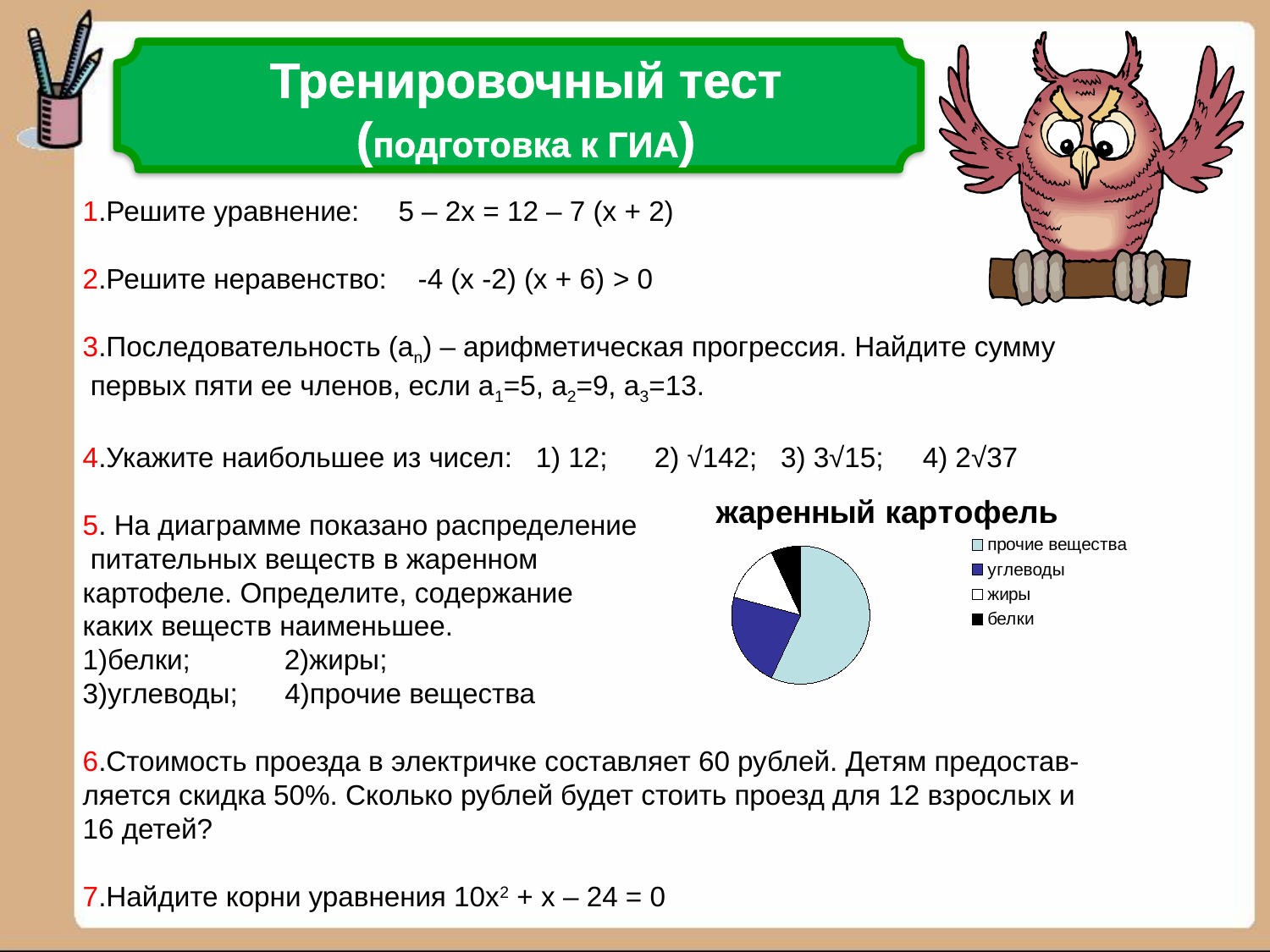
What is the title of the pie chart? жаренный картофель Which slice is larger in the pie chart, прочие вещества or углеводы? прочие вещества How many categories does the pie chart's legend list? 4 Which slice is larger in the pie chart, жиры or белки? жиры What kind of chart is shown on the slide? pie chart Which category has the largest slice in the pie chart? прочие вещества How many slices does the pie chart have? 4 Which slice is larger in the pie chart, углеводы or жиры? углеводы Which category in the pie chart is shown in black? белки Which category has the smallest slice in the pie chart? белки